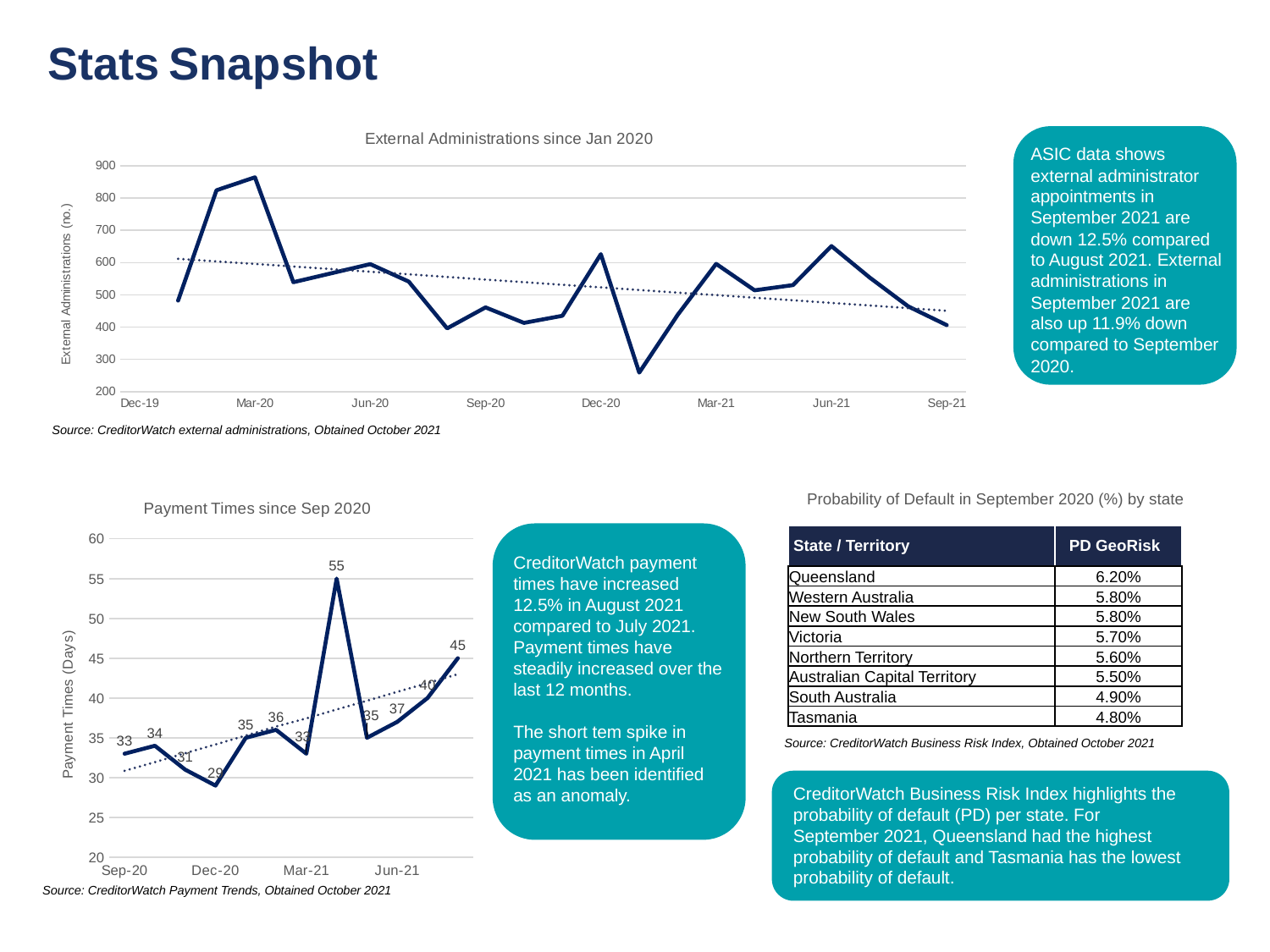
In the External Administrations since Jan 2020 chart, is the value at Sep-21 greater or less than 500? less In the Payment Times since Sep 2020 chart, what is the highest value shown? 55 In the Payment Times since Sep 2020 chart, does the dotted trend line rise or fall from left to right? rise In the Payment Times since Sep 2020 chart, what is the payment time at Sep-20? 33 In the Payment Times since Sep 2020 chart, what is the value of the last data point? 45 In the External Administrations since Jan 2020 chart, is the peak value in early 2020 greater or less than 800? greater In the Payment Times since Sep 2020 chart, what is the payment time at Dec-20? 29 In the Payment Times since Sep 2020 chart, how many data points are plotted? 12 What kind of chart is the External Administrations since Jan 2020 chart? line chart In the Payment Times since Sep 2020 chart, what is the difference between the highest value and the lowest value? 26 In the External Administrations since Jan 2020 chart, does the dotted trend line rise or fall from left to right? fall In the Payment Times since Sep 2020 chart, what is the lowest value shown? 29